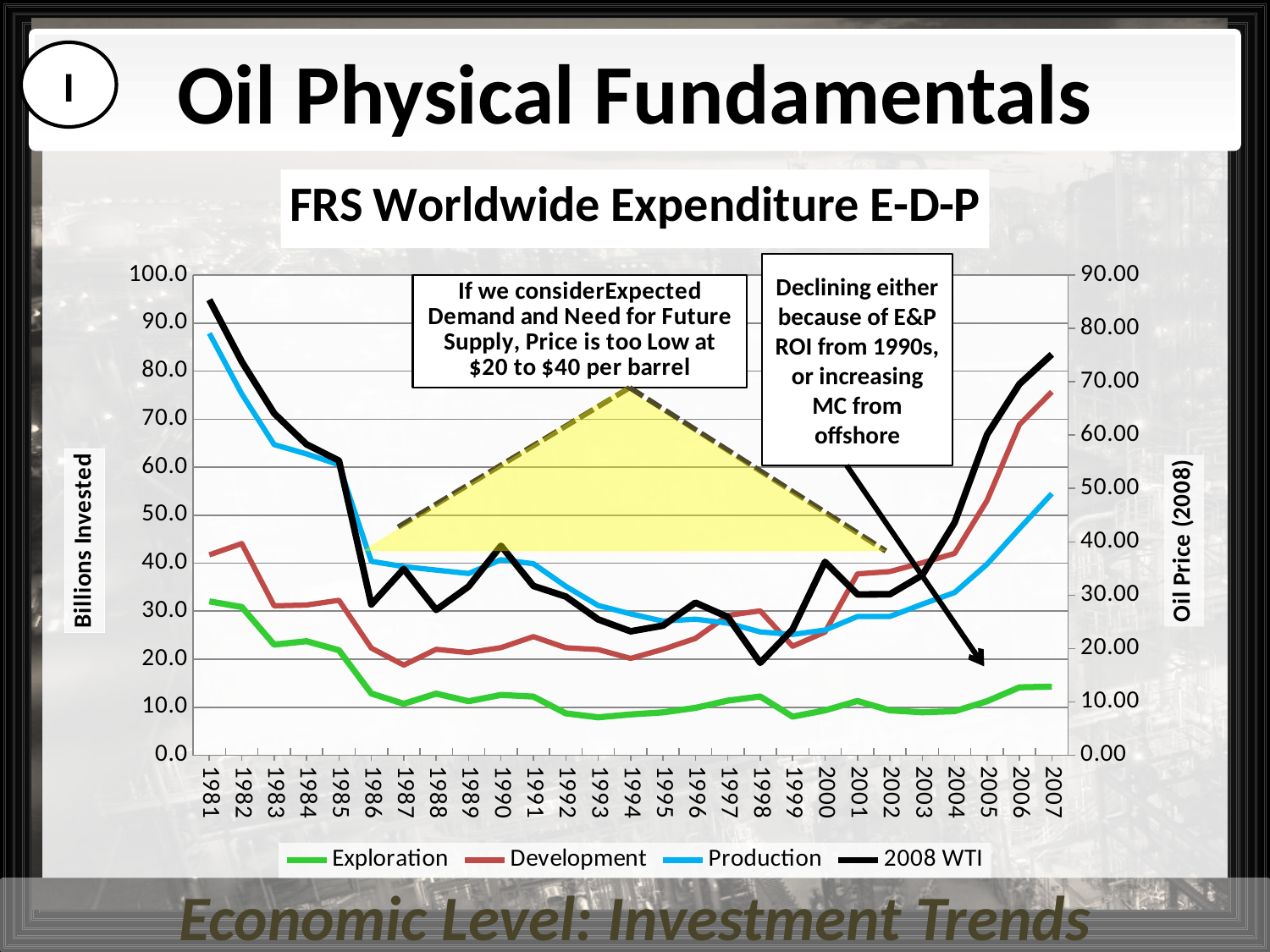
In 2007, which is larger, Development or Production? Development How many years are plotted along the x axis? 27 Does the Exploration series rise or fall from 1981 to 1986? Fall Is the Development value in 2007 greater or less than 70? greater What kind of chart is shown on the slide? Line chart Is the Production value in 1981 greater or less than 80? greater How many series does the chart legend list? 4 What is the label of the left vertical axis? Billions Invested What is the title of the chart? FRS Worldwide Expenditure E-D-P Is the Production value in 1986 greater or less than 50? less In which year is the Production series at its highest? 1981